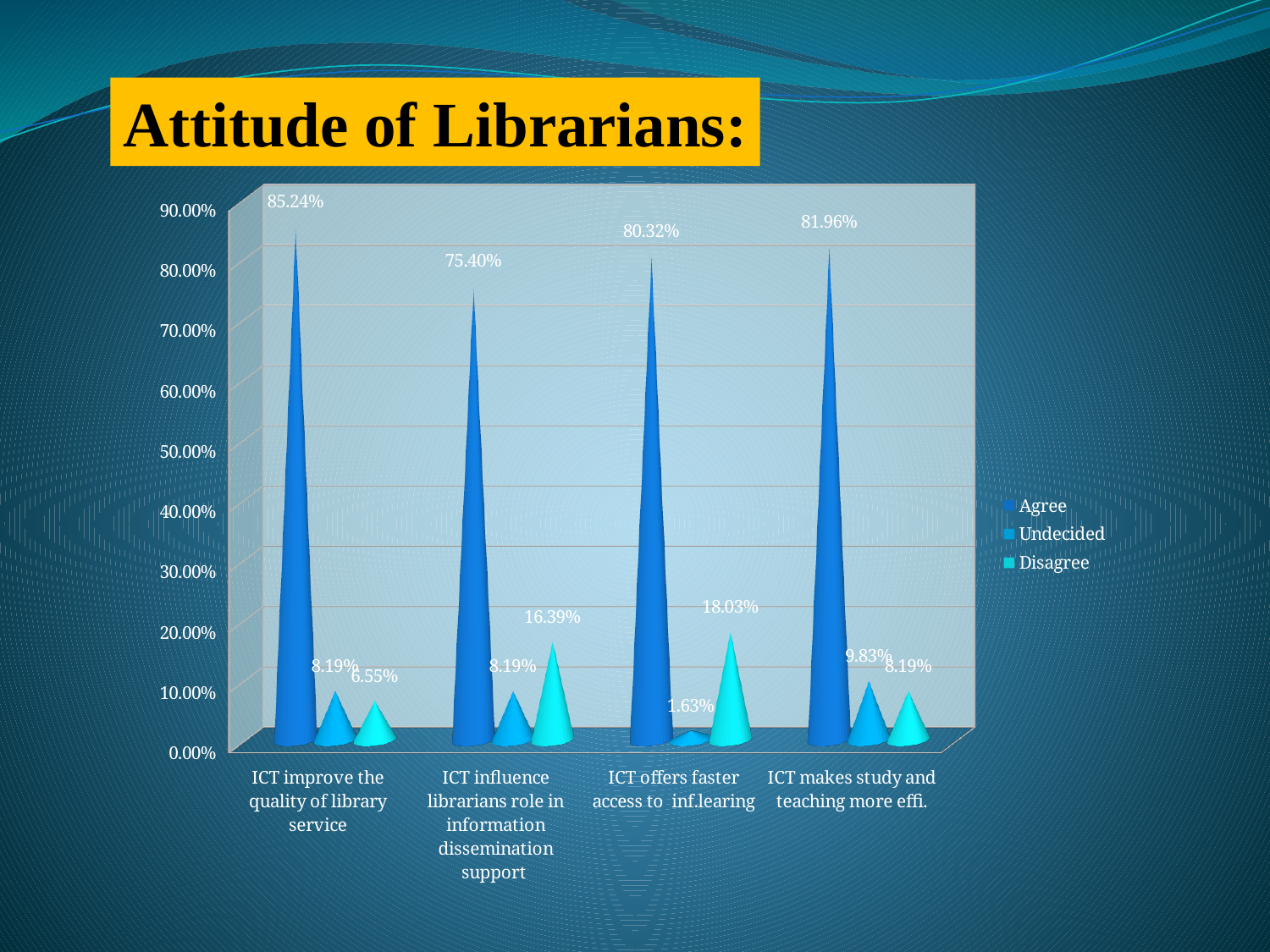
What kind of chart is shown on the slide? Bar chart Which category has the highest Agree value? ICT improve the quality of library service How many series does the legend list? 3 What is the Disagree value for "ICT offers faster access to inf.learing"? 18.03% What is the Agree value for "ICT improve the quality of library service"? 85.24% What is the Undecided value for "ICT makes study and teaching more effi."? 9.83% Which is larger: the Disagree value for "ICT offers faster access to inf.learing" or the Disagree value for "ICT makes study and teaching more effi."? ICT offers faster access to inf.learing What is the title of the slide? Attitude of Librarians: How many categories are shown on the x axis? 4 What is the difference between the Agree values for "ICT improve the quality of library service" and "ICT influence librarians role in information dissemination support"? 9.84% Which category has the lowest Undecided value? ICT offers faster access to inf.learing What is the Disagree value for "ICT influence librarians role in information dissemination support"? 16.39%